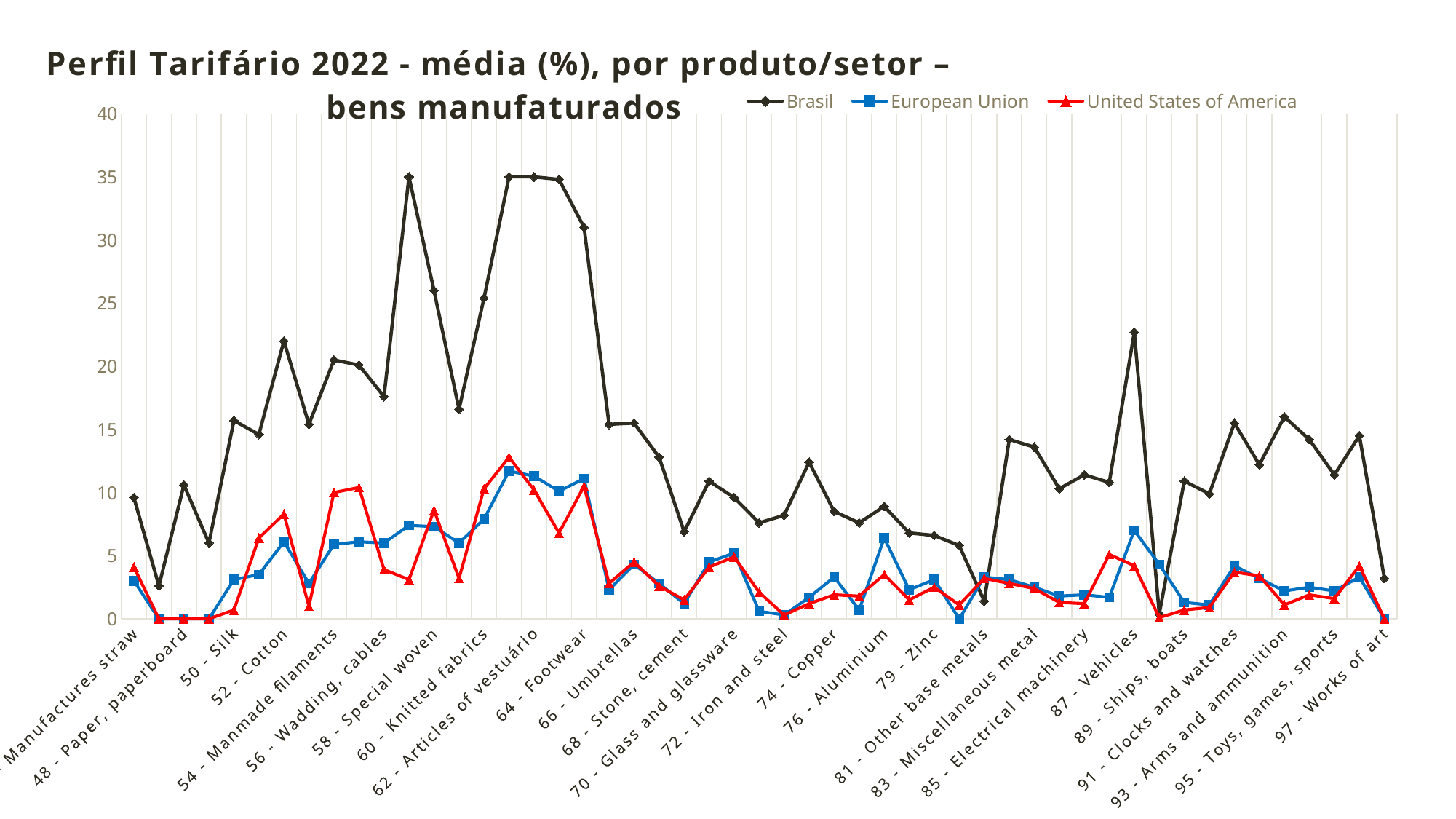
Is the Brasil value for 52 - Cotton greater or less than 20? greater Does the Brasil line rise or fall from 62 - Articles of vestuário to 66 - Umbrellas? fall Is the Brasil value for 81 - Other base metals greater or less than 5? less Which series reaches the highest value anywhere on the chart? Brasil Is the Brasil value for 87 - Vehicles greater or less than 20? greater Which series are listed in the legend? Brasil, European Union, United States of America At 76 - Aluminium, which is larger: the European Union value or the United States of America value? European Union At 62 - Articles of vestuário, which is larger: the Brasil value or the European Union value? Brasil How many series does the legend list? 3 What kind of chart is shown on the slide? line chart